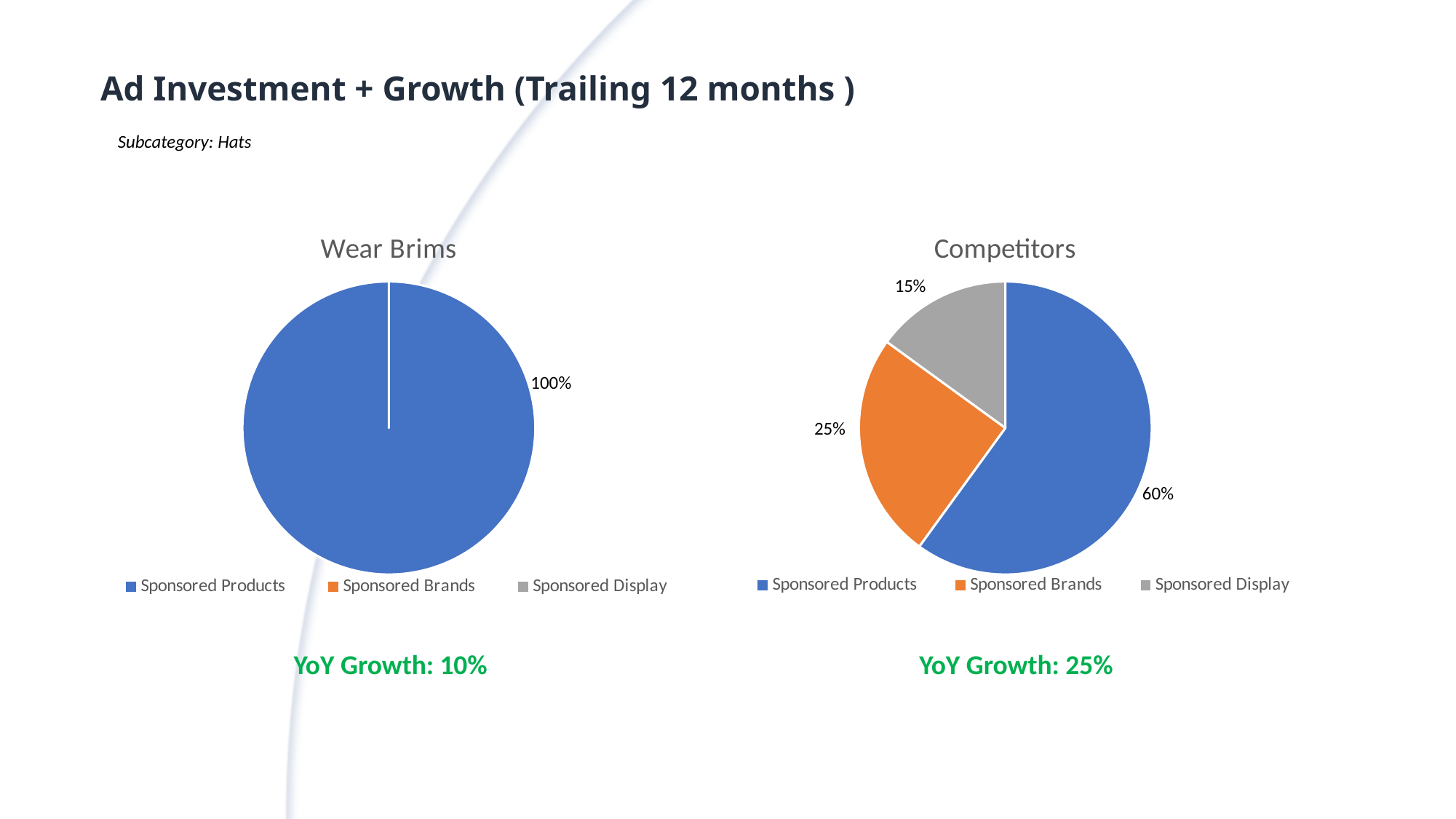
In the Competitors chart, what share does Sponsored Brands have? 25% In the Competitors chart, which ad type has the largest share? Sponsored Products How many entries does the legend of the Competitors chart list? 3 In the Competitors chart, what is the difference between the Sponsored Products share and the Sponsored Brands share? 35% In the Competitors chart, what share does Sponsored Display have? 15% What colour represents Sponsored Brands in the Competitors chart? Orange What is the title of the chart on the left of the slide? Wear Brims In the Wear Brims chart, what share does Sponsored Products have? 100% In the Competitors chart, which is larger: Sponsored Brands or Sponsored Display? Sponsored Brands In the Competitors chart, what share does Sponsored Products have? 60% In the Competitors chart, which ad type has the smallest share? Sponsored Display What kind of chart is the Wear Brims chart? Pie chart